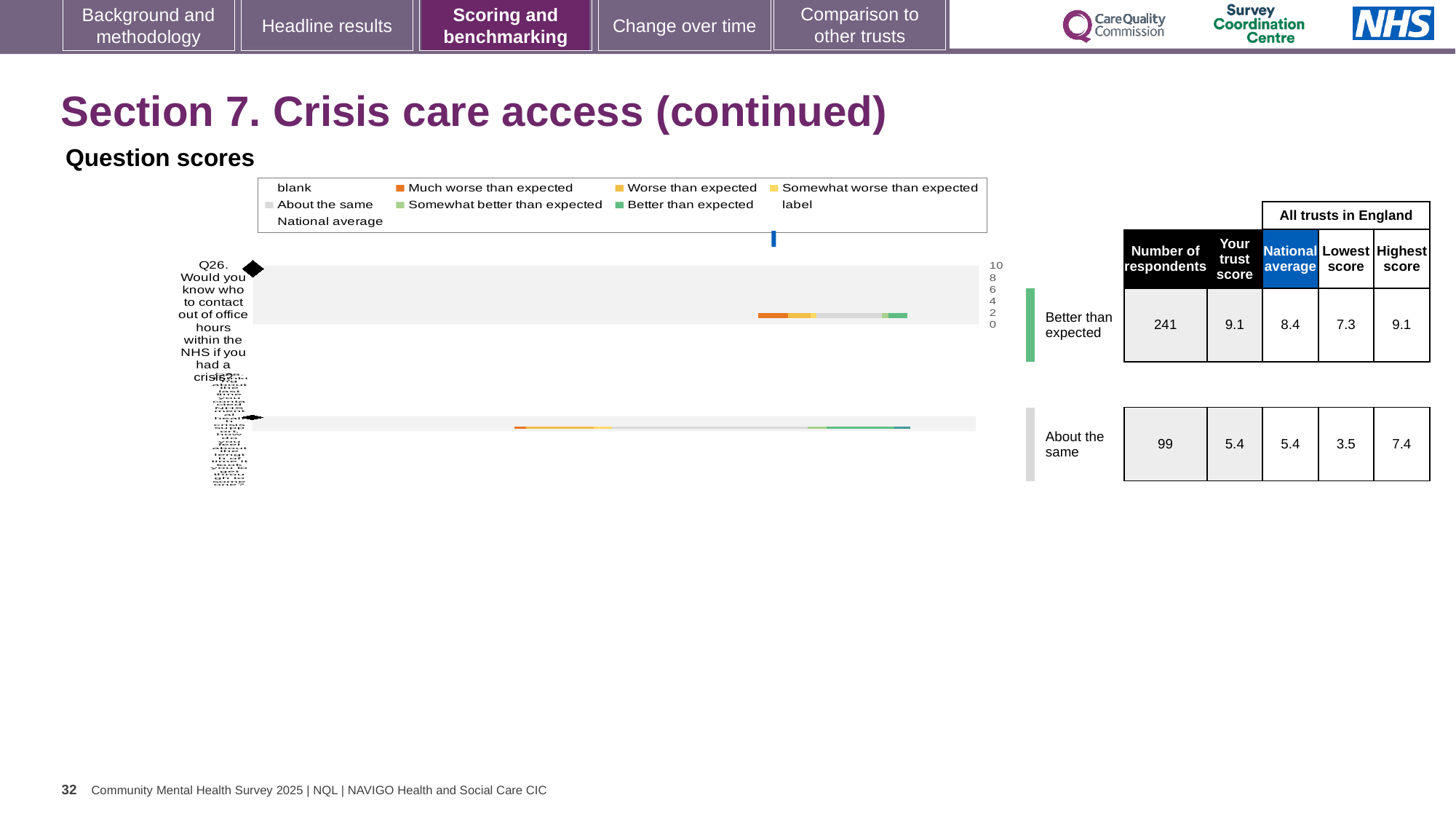
What is the lowest score among all trusts in England for the second question row? 3.5 What is the trust score for the second question row, rated 'About the same'? 5.4 What is the trust score for Q26 (Would you know who to contact out of office hours within the NHS if you had a crisis?)? 9.1 How many respondents answered Q26? 241 How many survey questions are plotted in the question scores chart? 2 For Q26, which is larger: the trust score or the national average? the trust score What is the national average score for Q26? 8.4 What kind of chart is used to show the question scores on this slide? bar chart What benchmark category is shown for Q26? Better than expected For the second question row, what is the difference between the highest score (7.4) and the lowest score (3.5)? 3.9 Which question row has more respondents, Q26 or the second question row? Q26 For Q26, what is the difference between the highest score and the lowest score among all trusts in England? 1.8